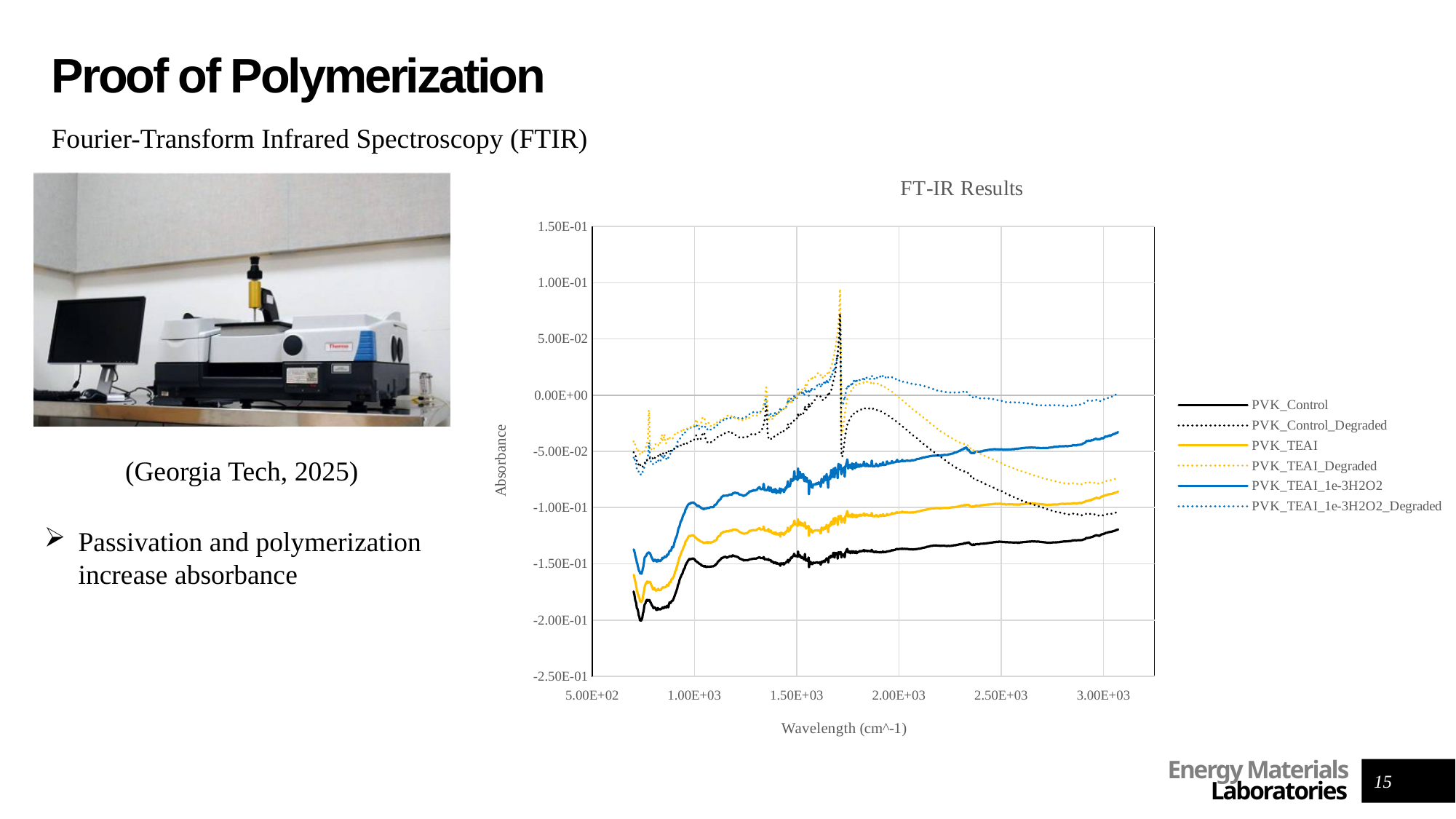
In the FT-IR Results chart, is the value for PVK_TEAI_1e-3H2O2 at 3.00E+03 greater or less than -5.00E-02? greater In the FT-IR Results chart, does the PVK_Control series generally rise or fall as wavelength increases from 5.00E+02 to 3.00E+03? rise In the FT-IR Results chart, which series has the lowest absorbance across the wavelength range? PVK_Control What is the x-axis label of the FT-IR Results chart? Wavelength (cm^-1) What is the title of the chart on the slide? FT-IR Results In the FT-IR Results chart, which series has the higher absorbance at 2.00E+03: PVK_Control_Degraded or PVK_TEAI_1e-3H2O2_Degraded? PVK_TEAI_1e-3H2O2_Degraded In the FT-IR Results chart, is the value for PVK_Control at 3.00E+03 greater or less than -1.00E-01? less What kind of chart is the FT-IR Results chart? line chart In the FT-IR Results chart, which series has the higher absorbance at 3.00E+03: PVK_TEAI or PVK_Control? PVK_TEAI In the FT-IR Results chart, is the peak value of PVK_TEAI_Degraded near 1.70E+03 greater or less than 5.00E-02? greater How many series does the legend of the FT-IR Results chart list? 6